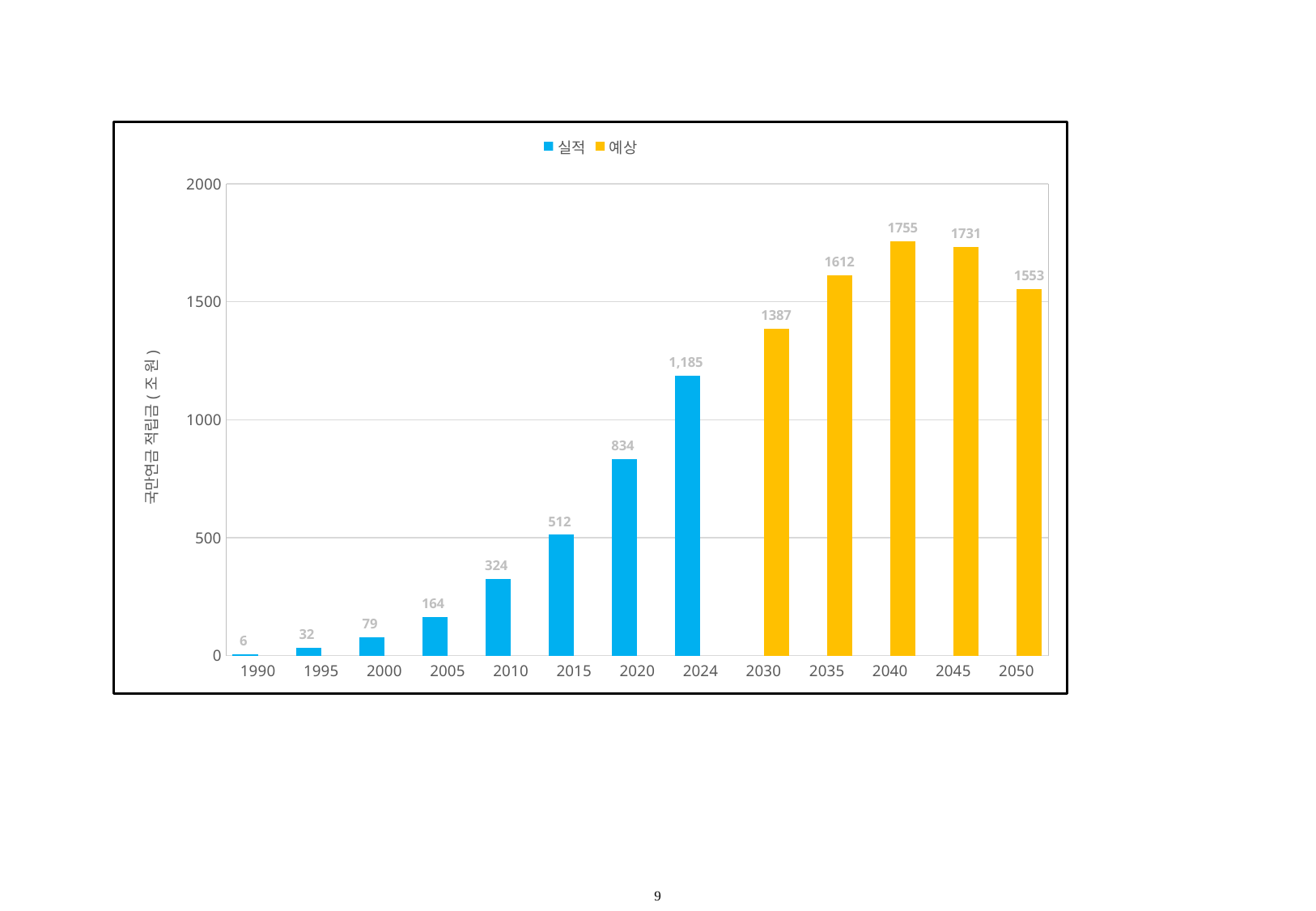
What is the difference between the values for 2030 and 2024? 202 How many years are shown on the x axis? 13 Which year has the lowest value? 1990 How many series does the legend list? 2 Which series do the yellow bars represent? 예상 What is the value for 2024? 1,185 What kind of chart is this? bar chart What is the value for 2040? 1755 Is the value for 2035 greater or less than 1500? greater What is the value for 1990? 6 Which is larger, the value for 2045 or the value for 2050? 2045 Which year has the highest value? 2040